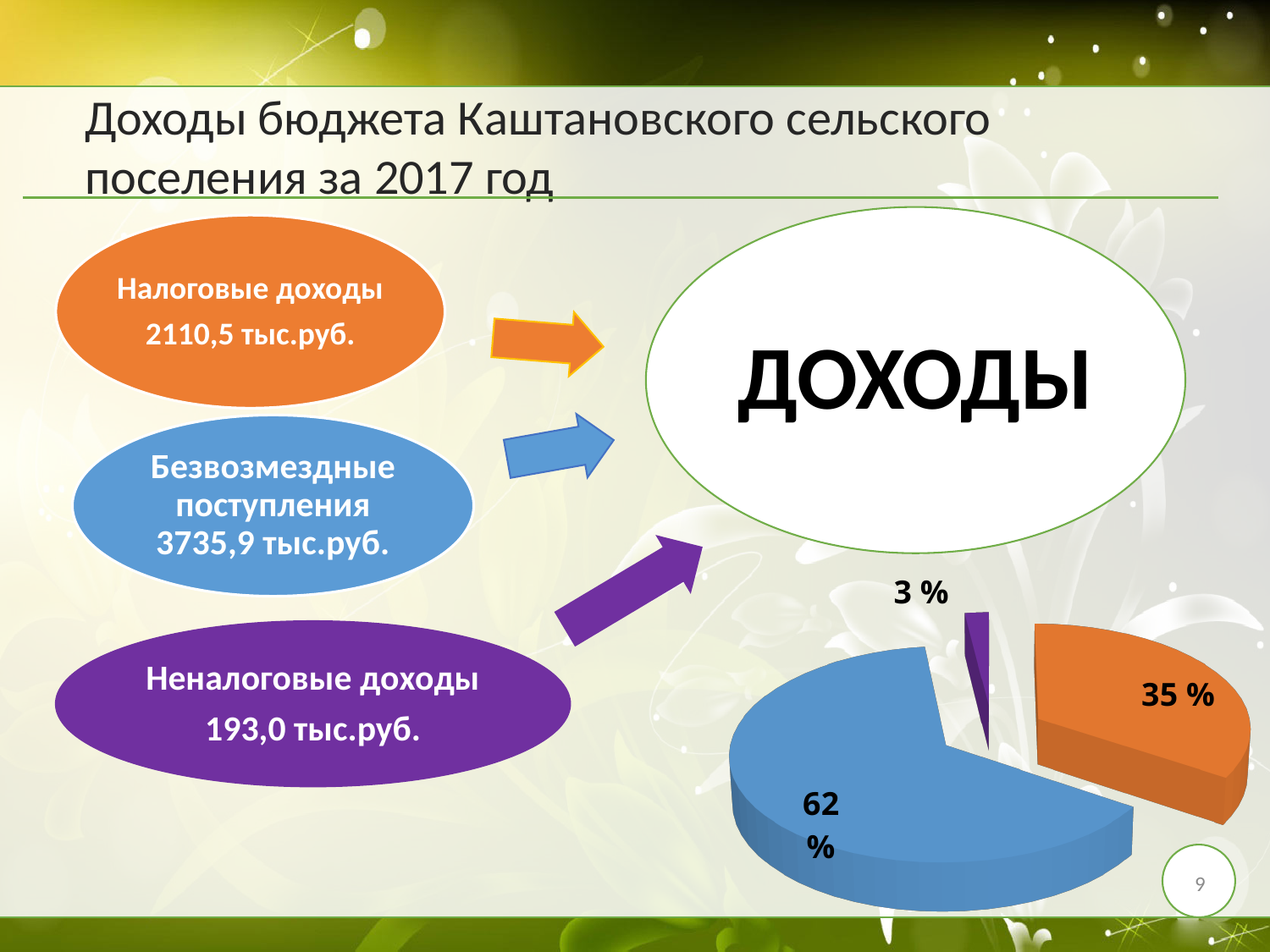
What do the three percentages in the pie chart add up to? 100 % What colour is the largest slice of the pie chart? blue What is the value of the smallest slice in the pie chart? 3 % What percentage is shown for the blue slice of the pie chart? 62 % Which slice is larger in the pie chart, the orange one or the purple one? orange What is the value of the largest slice in the pie chart? 62 % How many slices does the pie chart have? 3 What kind of chart is shown on the slide? pie chart What percentage is shown for the purple slice of the pie chart? 3 % What percentage is shown for the orange slice of the pie chart? 35 % What is the difference between the blue slice and the orange slice in the pie chart? 27 % What is the difference between the orange slice and the purple slice in the pie chart? 32 %